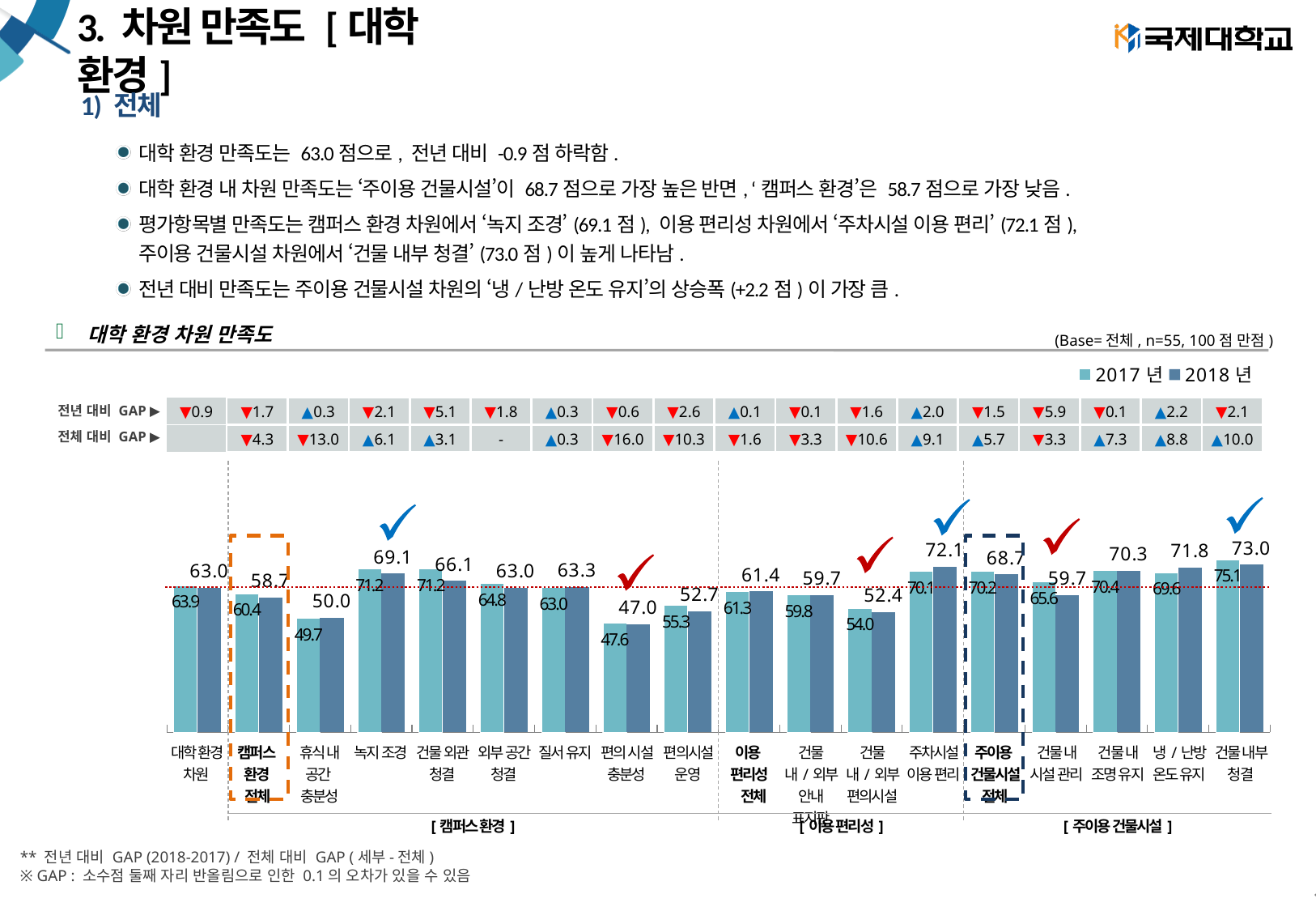
What is the difference between the 2017년 and 2018년 values for 건물내 시설 관리? 5.9 What is the 2017년 value for 건물내부 청결? 75.1 What kind of chart is shown on the slide? Bar chart Which category has the highest 2018년 value? 건물내부 청결 What is the difference between the 2018년 and 2017년 values for 주차시설 이용 편리? 2.0 How many series does the legend list? 2 Which category has the lowest 2017년 value? 편의시설 충분성 What is the 2018년 value for 캠퍼스 환경 전체? 58.7 What is the 2018년 value for 녹지 조경? 69.1 How many categories are shown on the x axis of the chart? 18 Which category has the lowest 2018년 value? 편의시설 충분성 Which has the larger 2018년 value, 녹지 조경 or 건물 외관 청결? 녹지 조경